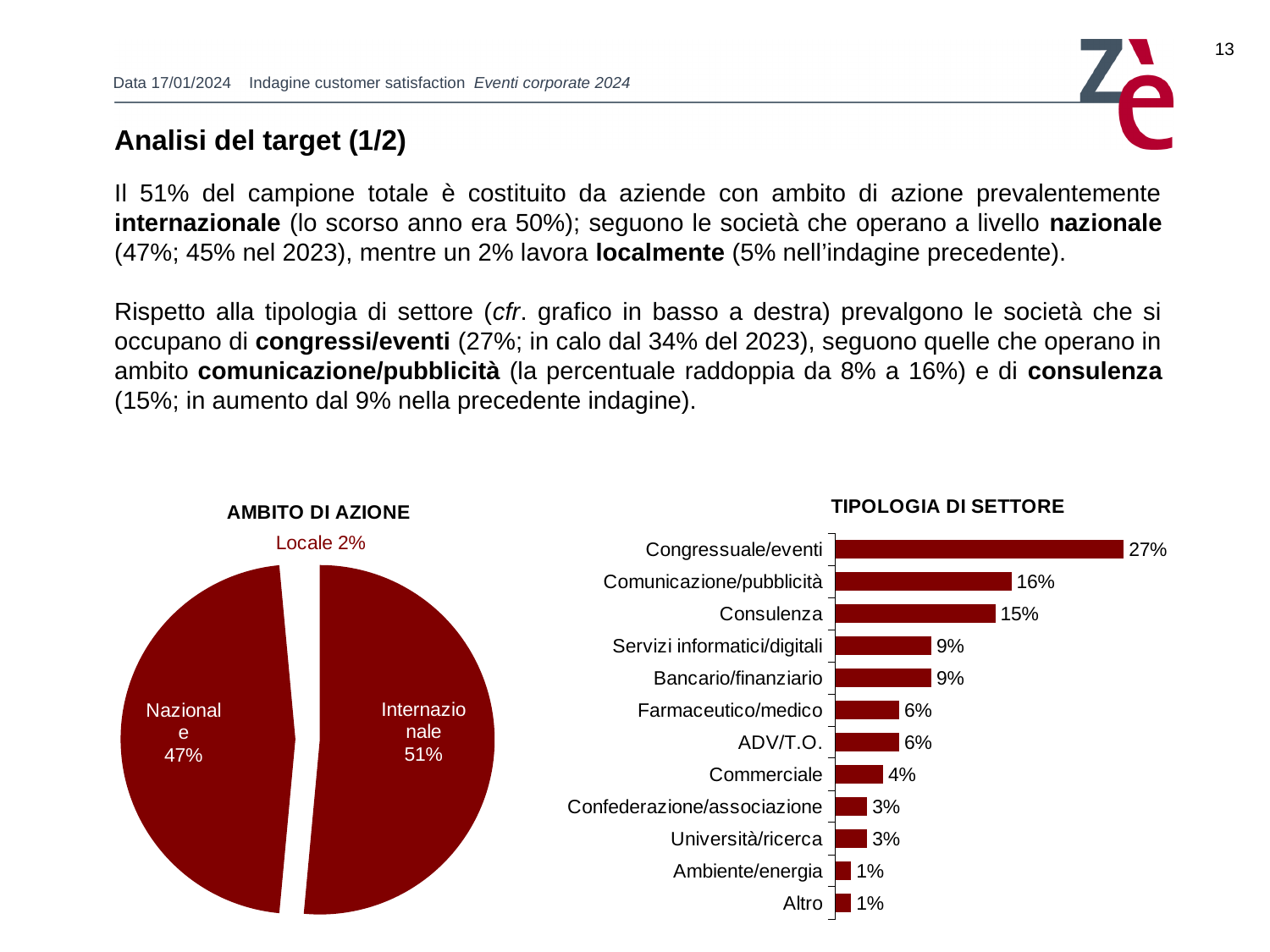
How many categories are shown in the TIPOLOGIA DI SETTORE chart? 12 What kind of chart is the AMBITO DI AZIONE chart? Pie chart What kind of chart is the TIPOLOGIA DI SETTORE chart? Bar chart In the TIPOLOGIA DI SETTORE chart, which is larger, Farmaceutico/medico or Commerciale? Farmaceutico/medico In the TIPOLOGIA DI SETTORE chart, what is the value for Servizi informatici/digitali? 9% In the AMBITO DI AZIONE chart, what share of the pie is Nazionale? 47% In the TIPOLOGIA DI SETTORE chart, what is the value for Consulenza? 15% How many slices does the AMBITO DI AZIONE pie chart have? 3 In the TIPOLOGIA DI SETTORE chart, what is the difference between Congressuale/eventi and Comunicazione/pubblicità? 11% In the AMBITO DI AZIONE chart, what share of the pie is Internazionale? 51% In the TIPOLOGIA DI SETTORE chart, which category has the highest value? Congressuale/eventi In the AMBITO DI AZIONE chart, what is the value for Locale? 2%